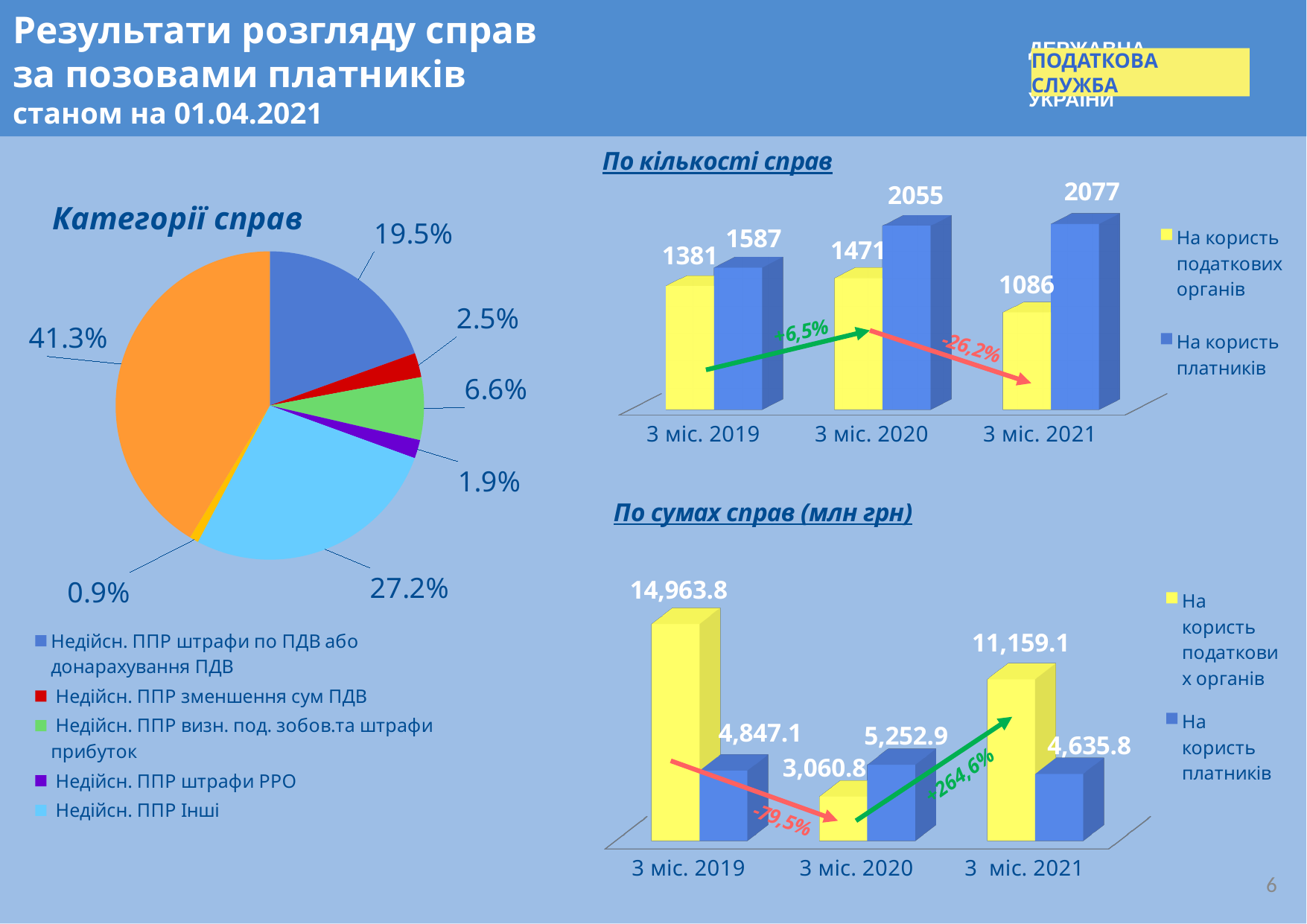
In the chart 'По кількості справ', in which period is the value for 'На користь платників' highest? 3 міс. 2021 In the chart 'По кількості справ', what is the value for 'На користь платників' in 3 міс. 2020? 2055 In the chart 'По кількості справ', what is the difference between 'На користь платників' and 'На користь податкових органів' in 3 міс. 2019? 206 In the pie chart 'Категорії справ', what share does 'Недійсн. ППР Інші' have? 27.2% In the chart 'По сумах справ (млн грн)', what is the value for 'На користь платників' in 3 міс. 2021? 4,635.8 In the chart 'По сумах справ (млн грн)', what is the value for 'На користь податкових органів' in 3 міс. 2019? 14,963.8 In the chart 'По кількості справ', how many series does the legend list? 2 In the chart 'По сумах справ (млн грн)', which is larger in 3 міс. 2020: 'На користь податкових органів' or 'На користь платників'? На користь платників In the chart 'По сумах справ (млн грн)', in which period is the value for 'На користь податкових органів' lowest? 3 міс. 2020 In the chart 'По кількості справ', what is the value for 'На користь податкових органів' in 3 міс. 2021? 1086 In the pie chart 'Категорії справ', what share does 'Недійсн. ППР штрафи РРО' have? 1.9% What kind of chart is 'Категорії справ'? Pie chart